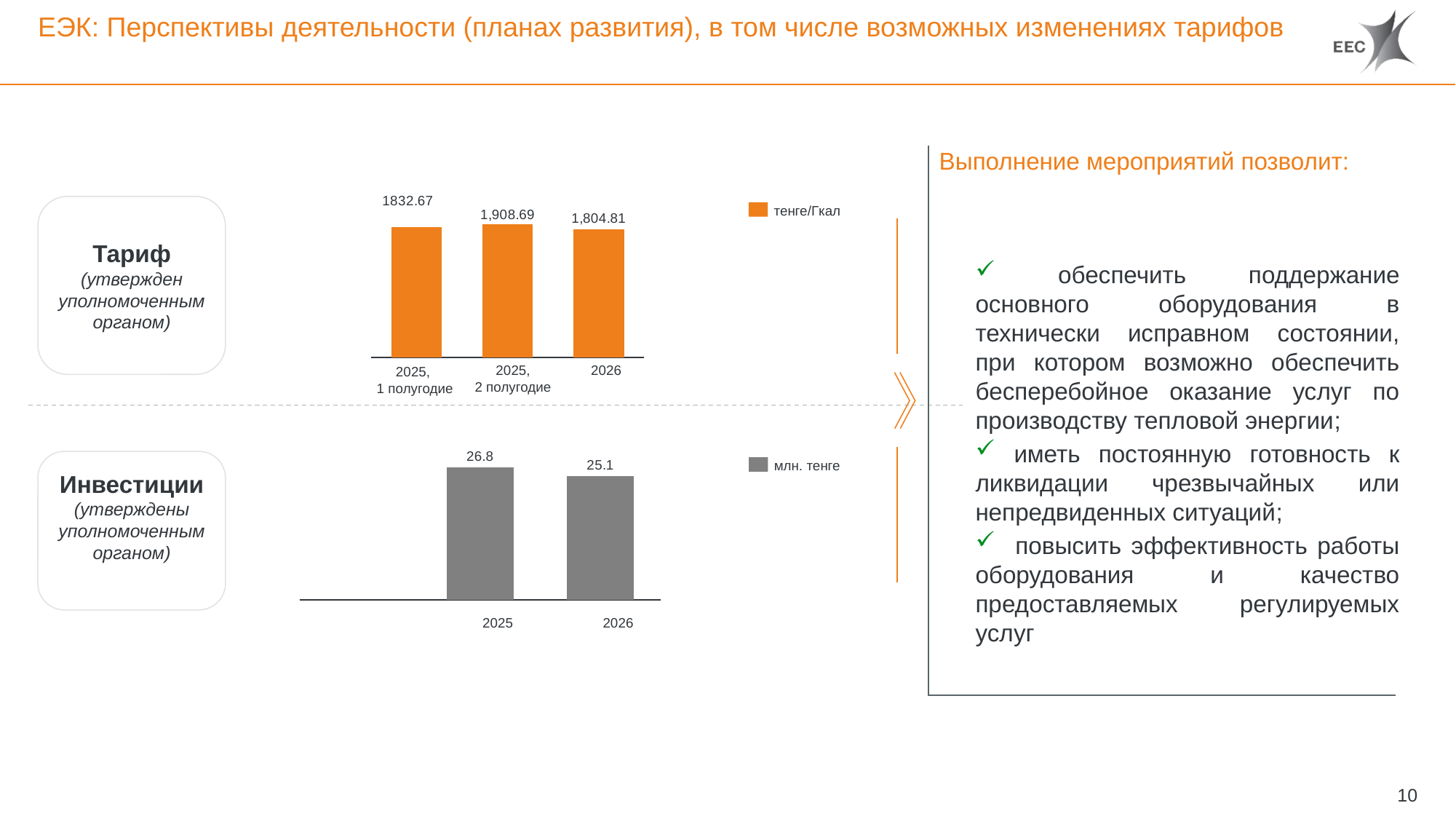
In the bottom (Инвестиции) chart, what is the value for 2026? 25.1 In the top (Тариф) chart, which category has the lowest value? 2026 In the bottom (Инвестиции) chart, what is the value for 2025? 26.8 In the top (Тариф) chart, what is the difference between the values for 2025, 2 полугодие and 2026? 103.88 In the top (Тариф) chart, what is the value for 2025, 2 полугодие? 1,908.69 What unit does the legend of the bottom (Инвестиции) chart show? млн. тенге In the bottom (Инвестиции) chart, do the values rise or fall from 2025 to 2026? fall In the top (Тариф) chart, which category has the highest value? 2025, 2 полугодие In the bottom (Инвестиции) chart, what is the difference between the values for 2025 and 2026? 1.7 In the top (Тариф) chart, how many bars are plotted? 3 In the top (Тариф) chart, what is the value for 2026? 1,804.81 In the top (Тариф) chart, what is the value for 2025, 1 полугодие? 1832.67